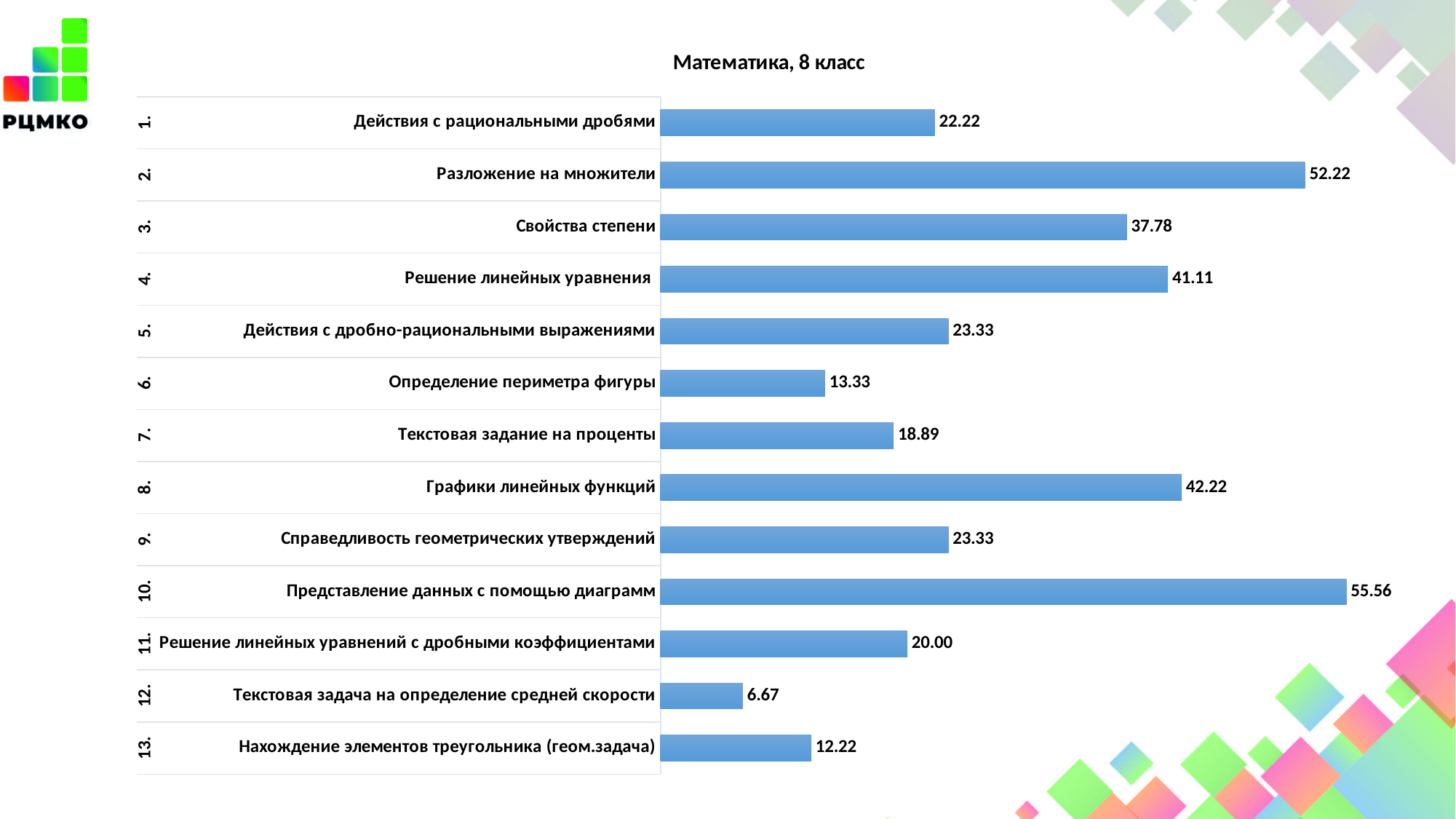
What is the title of the chart? Математика, 8 класс What is the value for "Определение периметра фигуры"? 13.33 Which category has the lowest value? Текстовая задача на определение средней скорости Which category has the highest value? Представление данных с помощью диаграмм What is the value for "Решение линейных уравнений с дробными коэффициентами"? 20.00 What is the value for "Графики линейных функций"? 42.22 What kind of chart is shown on the slide? Bar chart Which is larger: the value for "Решение линейных уравнения" or the value for "Графики линейных функций"? Графики линейных функций What is the difference between the values for "Представление данных с помощью диаграмм" and "Текстовая задача на определение средней скорости"? 48.89 What is the difference between the values for "Разложение на множители" and "Свойства степени"? 14.44 What is the value for "Разложение на множители"? 52.22 How many categories are shown in the chart? 13